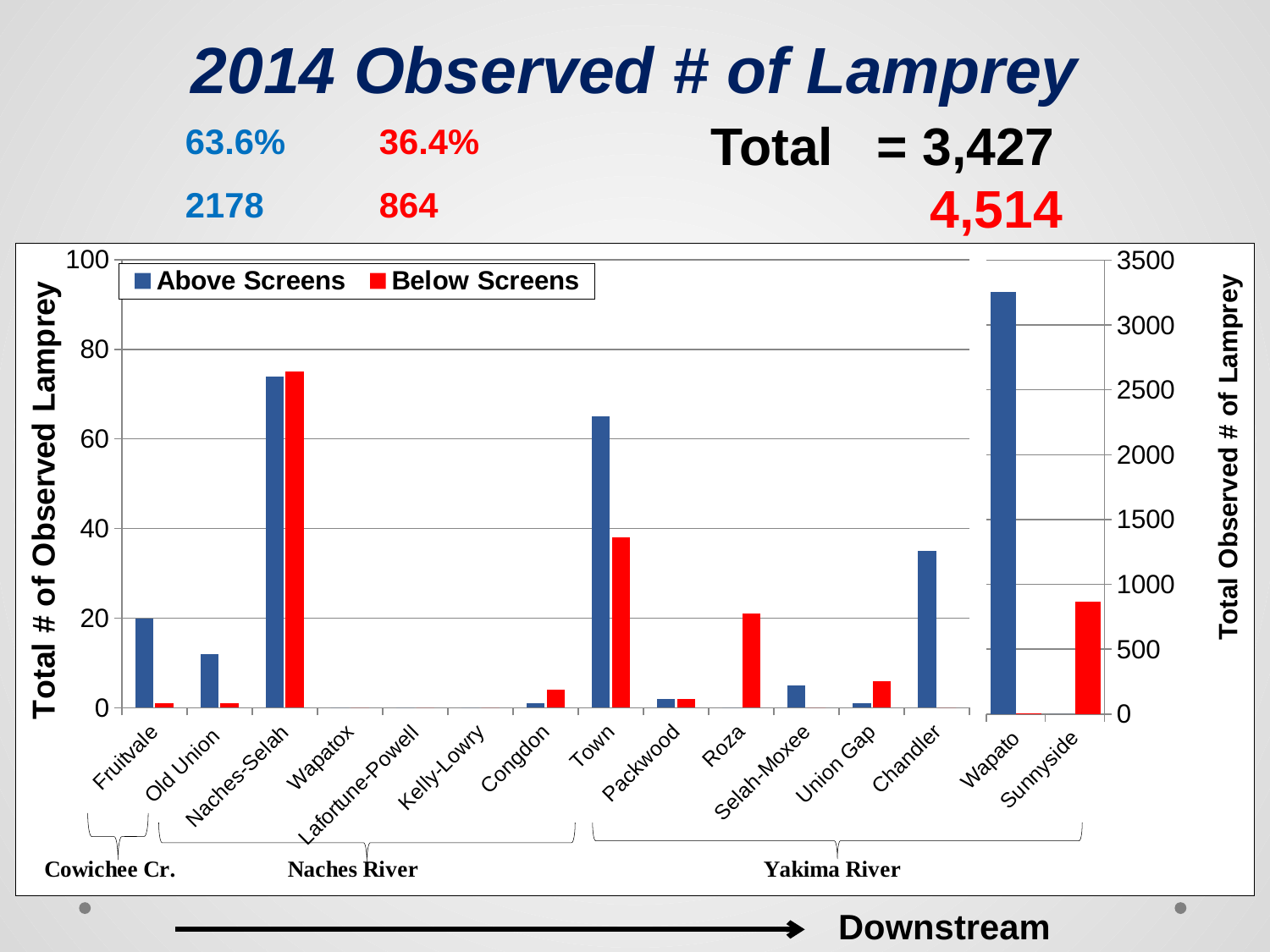
On the right-hand axis, is the Above Screens value for Wapato greater or less than 3000? greater Which site has the tallest Above Screens bar in the chart? Wapato At Roza, which is larger: Above Screens or Below Screens? Below Screens Is the Below Screens value for Town greater or less than 20? greater How many sites are shown along the x axis of the chart? 15 How many series does the chart legend list? 2 Is the Above Screens value for Naches-Selah greater or less than 60? greater What is the title of the chart? 2014 Observed # of Lamprey At Town, which is larger: Above Screens or Below Screens? Above Screens What are the two series named in the chart legend? Above Screens and Below Screens What kind of chart is shown on the slide? bar chart